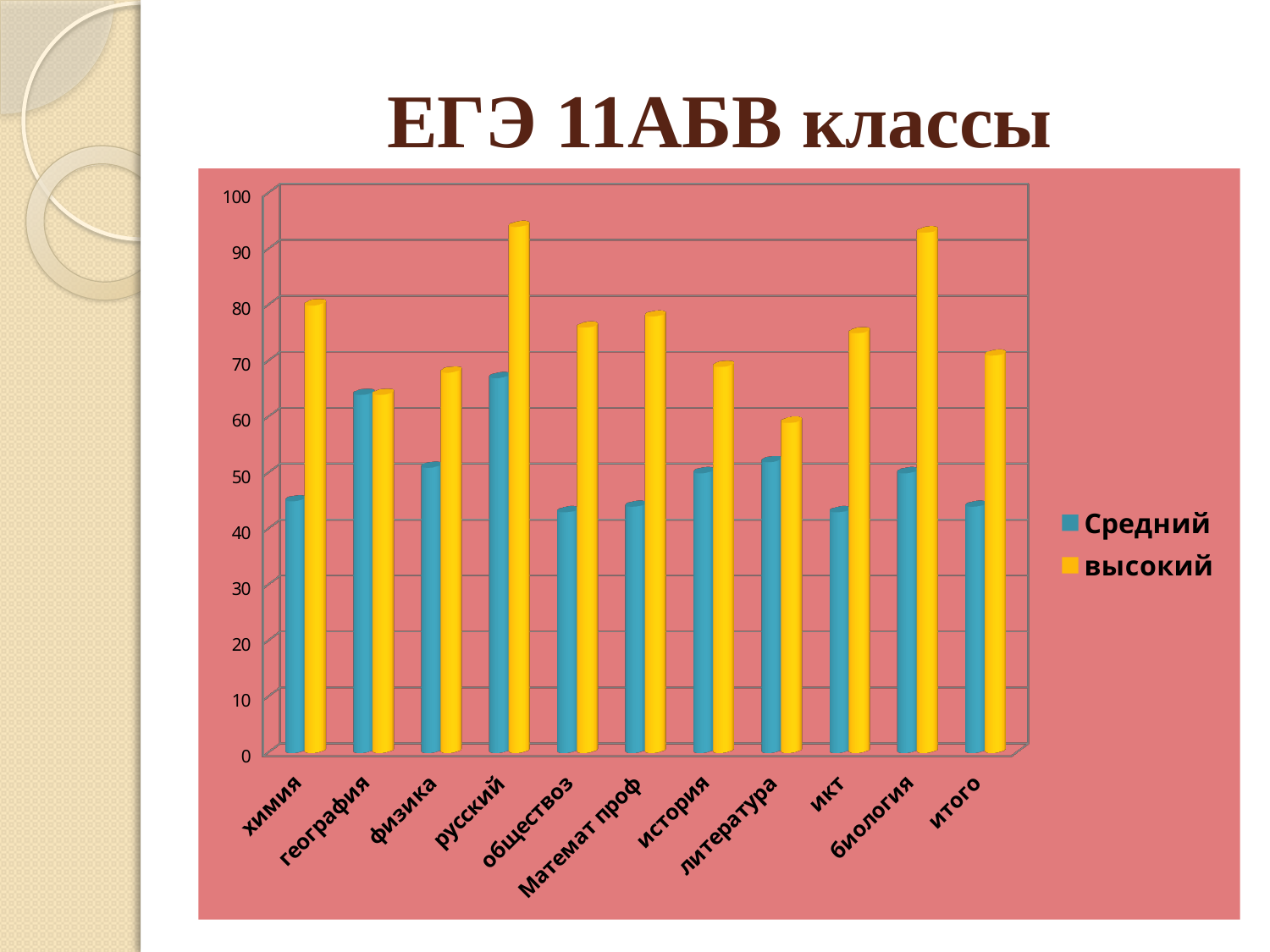
Which series has the lowest value for литература among the высокий bars across all categories — i.e., which category has the lowest высокий value? литература Is the Средний value for русский greater or less than 60? greater Is the Средний value for обществоз greater or less than 50? less How many series does the legend list? 2 What kind of chart is shown on the slide? bar chart Is the высокий value for биология greater or less than 90? greater How many categories are shown on the x axis? 11 What is the title of the slide containing the chart? ЕГЭ 11АБВ классы For химия, which is larger: the Средний value or the высокий value? высокий Which has the larger высокий value: русский or физика? русский